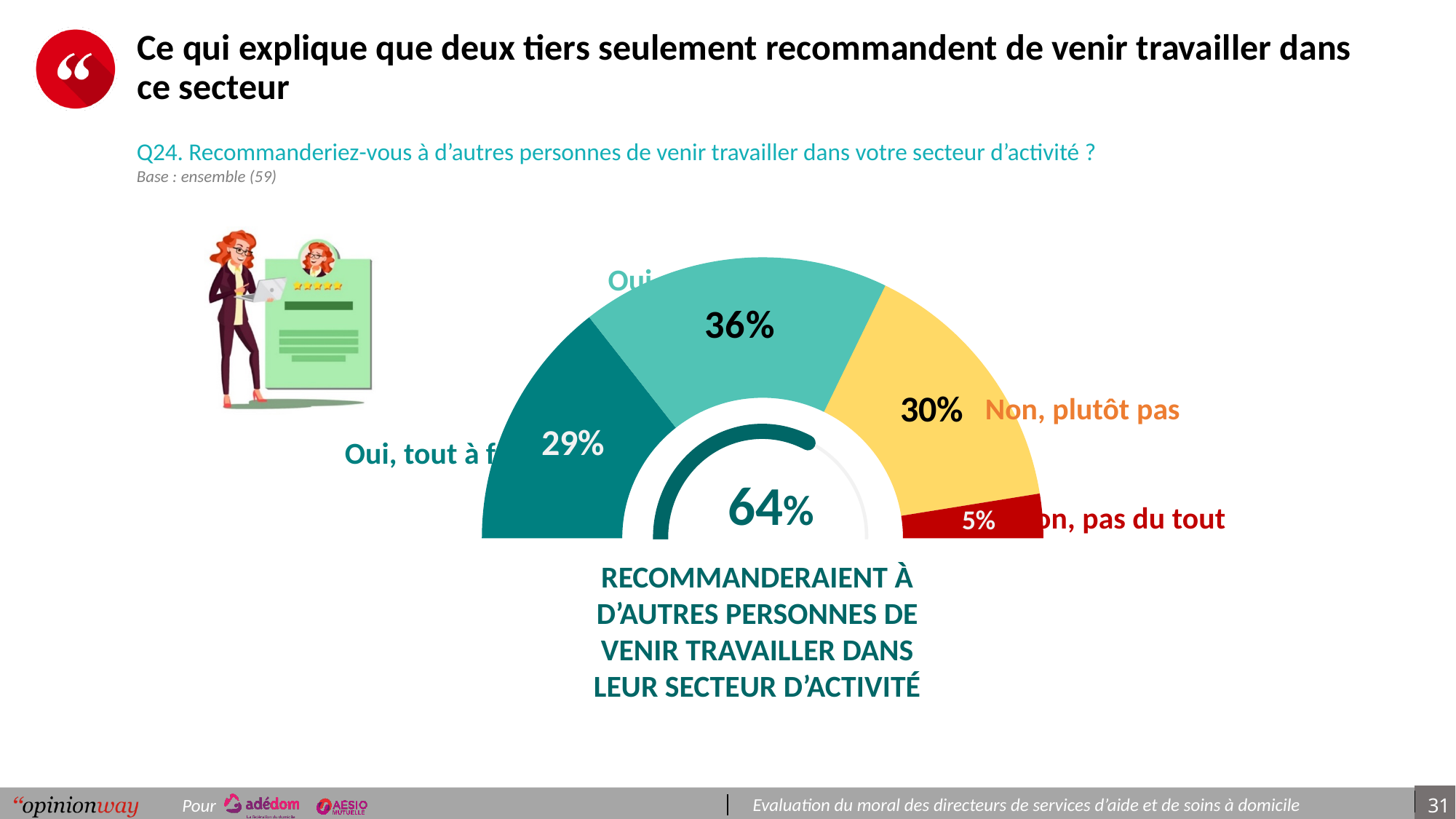
Which segment of the chart has the lowest percentage? Non, pas du tout (5%) What value is displayed in the centre of the gauge chart? 64% How many segments does the gauge chart contain? 4 What percentage is shown for the 'Non, plutôt pas' segment? 30% What percentage is shown for the dark teal 'Oui, tout à fait' segment? 29% What is the difference in percentage points between 'Oui, tout à fait' and 'Non, pas du tout'? 24 percentage points Which is larger: the 'Non, plutôt pas' segment or the 'Oui, tout à fait' segment? Non, plutôt pas What percentage is shown for the 'Non, pas du tout' segment? 5% What colour is the 'Non, pas du tout' segment? Red What is the difference in percentage points between the 36% segment and the 'Non, plutôt pas' segment? 6 percentage points What kind of chart is shown on the slide? A semicircular doughnut (gauge) chart Which segment of the chart has the highest percentage? The light teal 'Oui' segment (36%)